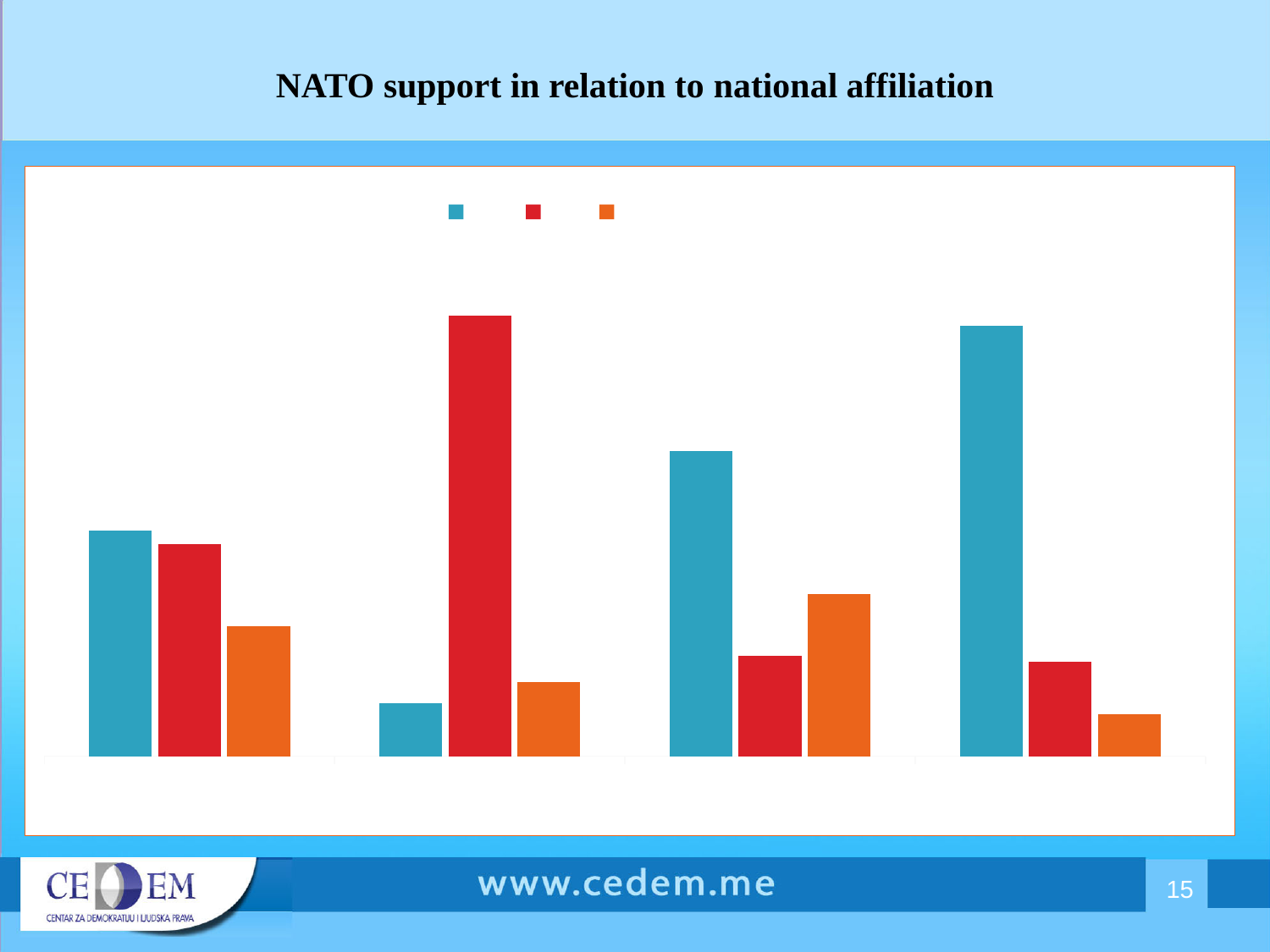
How many groups of bars are plotted along the x axis? 4 In the second group of bars from the left, which colour bar is the tallest? red In the second group of bars from the left, which colour bar is the shortest? blue In the fourth group of bars from the left, which colour bar is the tallest? blue What colours are the three series in the legend, from left to right? blue, red, orange What kind of chart is shown on the slide? bar chart In the third group of bars from the left, is the blue bar or the orange bar taller? blue What is the title of the slide? NATO support in relation to national affiliation In the first group of bars from the left, is the red bar or the orange bar taller? red Across all groups, which colour bar is the tallest on the chart? red How many series does the legend list? 3